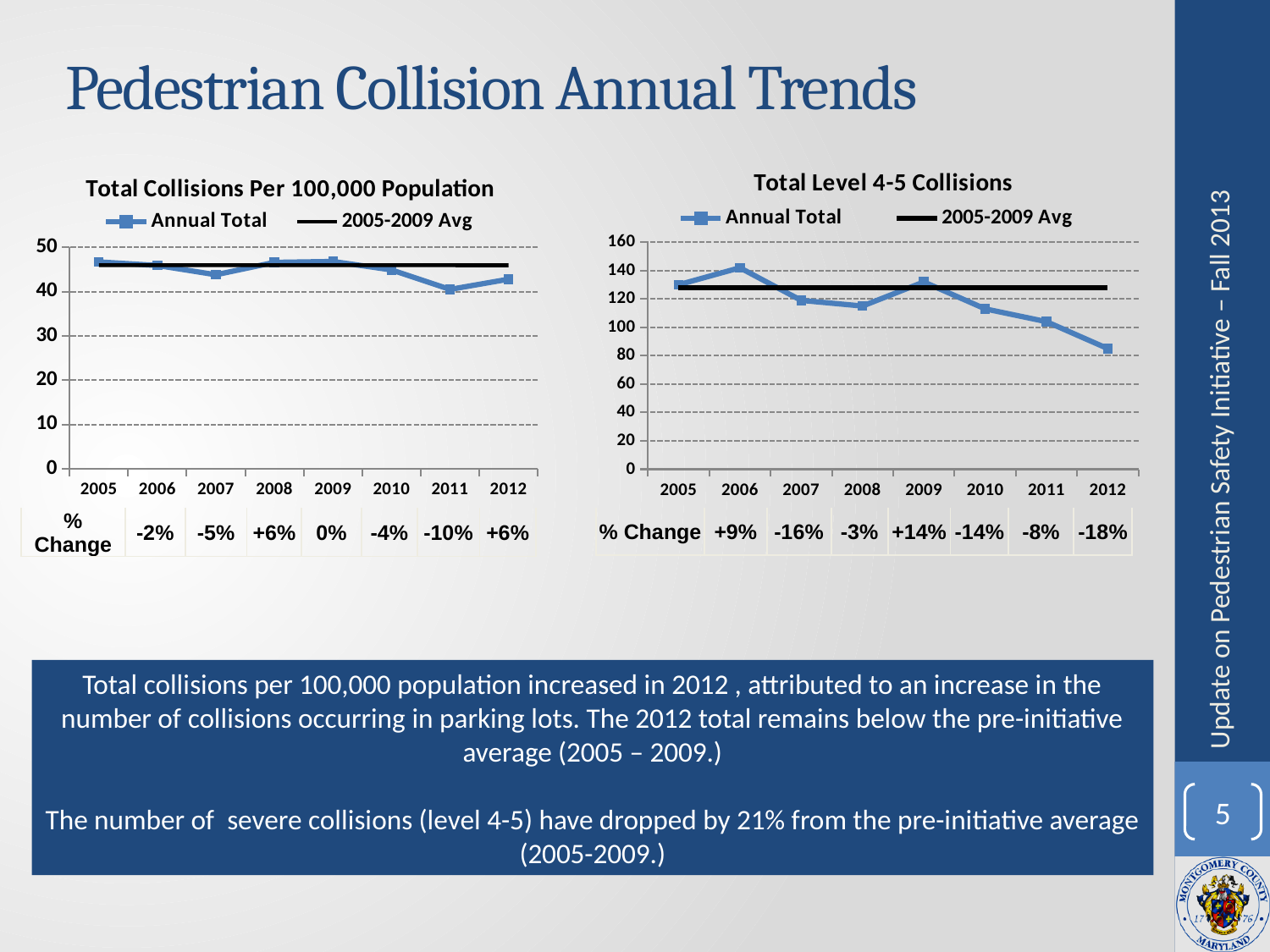
How many series does the legend of the 'Total Collisions Per 100,000 Population' chart list? 2 How many years are plotted on the x axis of the 'Total Level 4-5 Collisions' chart? 8 In the 'Total Level 4-5 Collisions' chart, which year has the highest Annual Total? 2006 What kind of chart is the 'Total Level 4-5 Collisions' chart? line chart In the 'Total Level 4-5 Collisions' chart, is the Annual Total for 2005 greater or less than 120? greater In the 'Total Level 4-5 Collisions' chart, which is larger, the Annual Total for 2006 or for 2012? 2006 In the 'Total Level 4-5 Collisions' chart, which year has the lowest Annual Total? 2012 In the 'Total Level 4-5 Collisions' chart, does the Annual Total generally rise or fall from 2005 to 2012? fall In the 'Total Level 4-5 Collisions' chart, is the Annual Total for 2012 greater or less than 100? less What are the two legend entries in the 'Total Collisions Per 100,000 Population' chart? Annual Total and 2005-2009 Avg In the 'Total Collisions Per 100,000 Population' chart, what is the % Change shown for 2011? -10% In the 'Total Collisions Per 100,000 Population' chart, which year has the lowest Annual Total? 2011